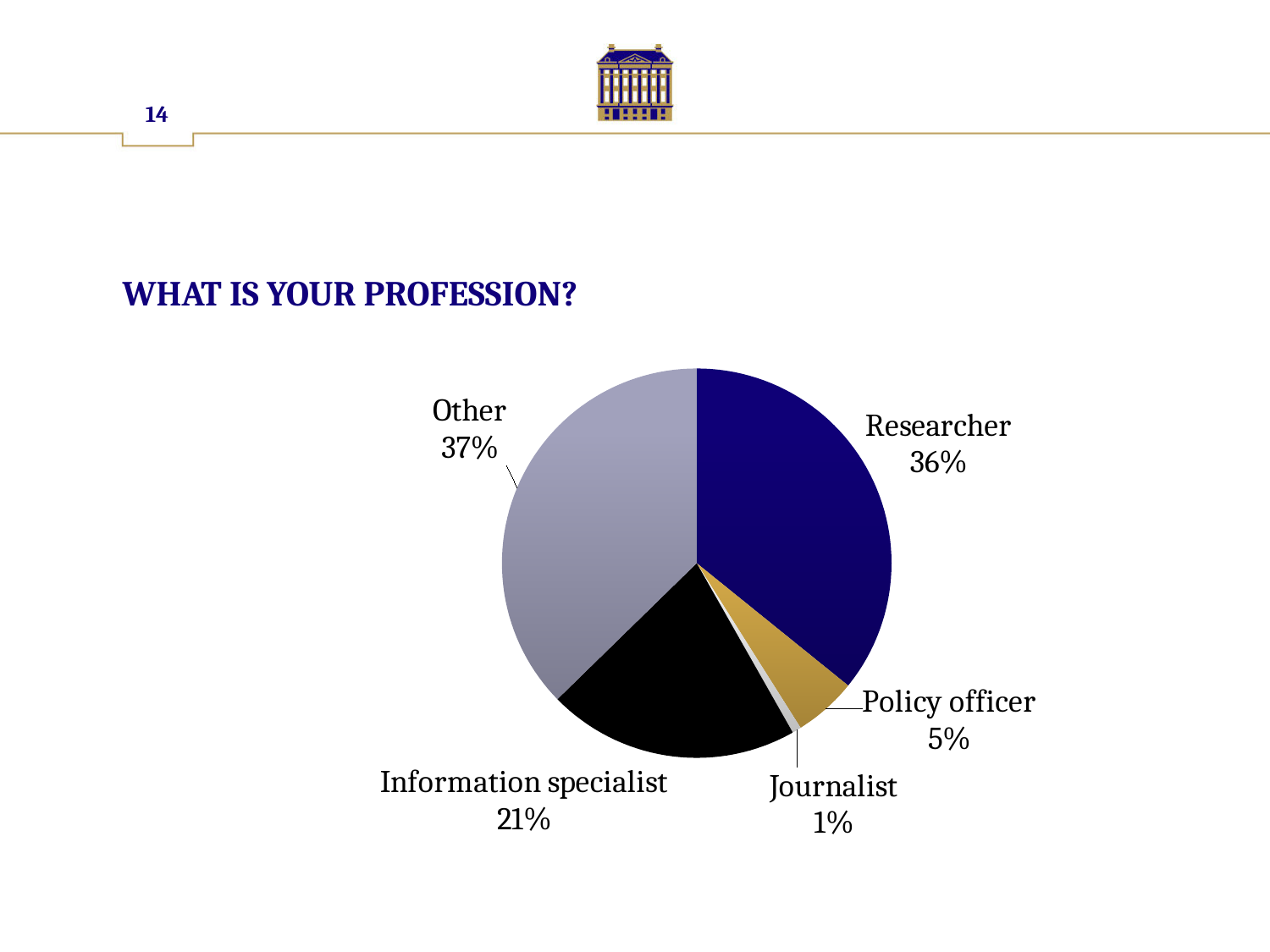
What percentage is shown for Journalist? 1% Which profession has the smallest slice of the pie? Journalist What percentage of respondents are researchers? 36% How many slices does the pie chart have? 5 What kind of chart is shown on the slide? pie chart What share of the pie is labelled Information specialist? 21% What is the difference in percentage points between Researcher and Journalist? 35 What is the title of the chart? WHAT IS YOUR PROFESSION? What percentage is shown for Other? 37% Which is larger, the share for Information specialist or the share for Policy officer? Information specialist What is the difference in percentage points between Information specialist and Policy officer? 16 What percentage is shown for Policy officer? 5%